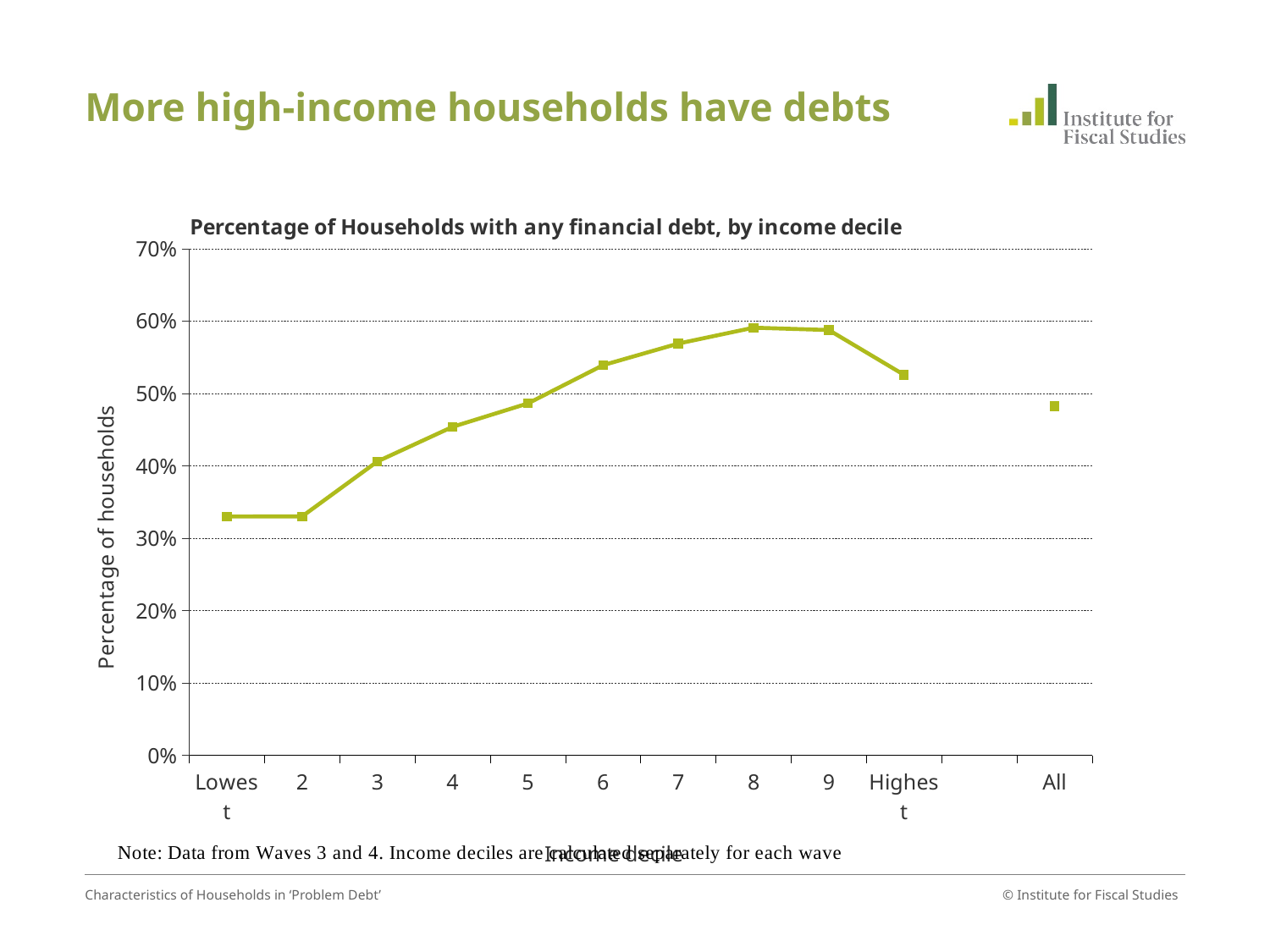
Does the percentage of households with financial debt rise or fall from the Lowest income decile to decile 8? rise Is the value for All households greater or less than 50%? less How many categories are shown along the x axis of the chart? 11 Is the value for the Highest income decile greater or less than 50%? greater Is the value for income decile 6 greater or less than 50%? greater Which has a higher percentage of households with financial debt, income decile 3 or income decile 7? 7 What is the title of the chart? Percentage of Households with any financial debt, by income decile What is the label on the vertical axis of the chart? Percentage of households What kind of chart is shown on the slide? line chart